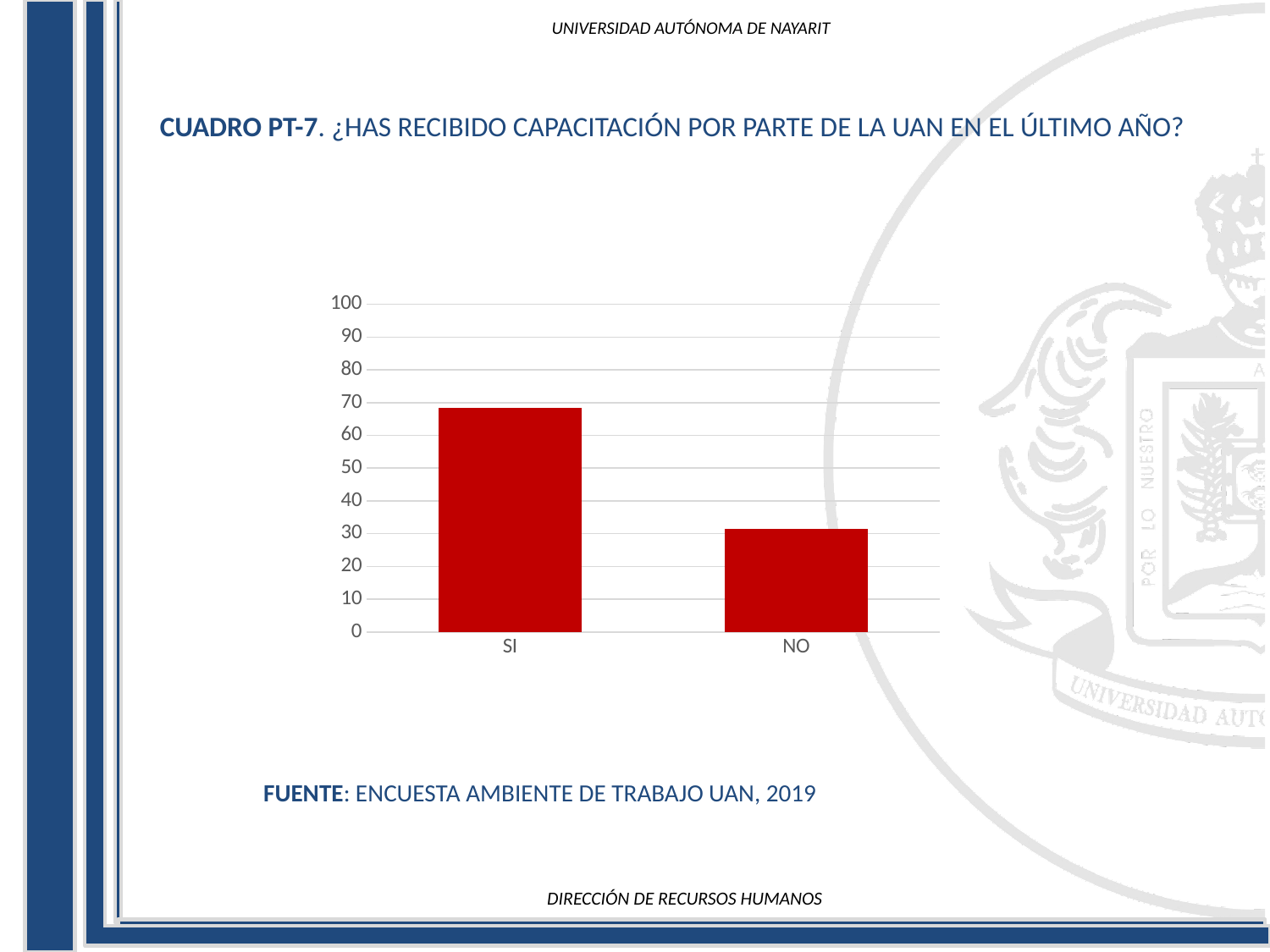
Is the value for NO greater or less than 40? less Which is larger, the value for SI or the value for NO? SI Which category has the highest value? SI Is the value for NO greater or less than 20? greater What kind of chart is shown on the slide? bar chart Is the value for SI greater or less than 60? greater How many categories are shown on the x axis? 2 What colour are the bars in the chart? red Which category has the lowest value? NO What is the highest value shown on the vertical axis? 100